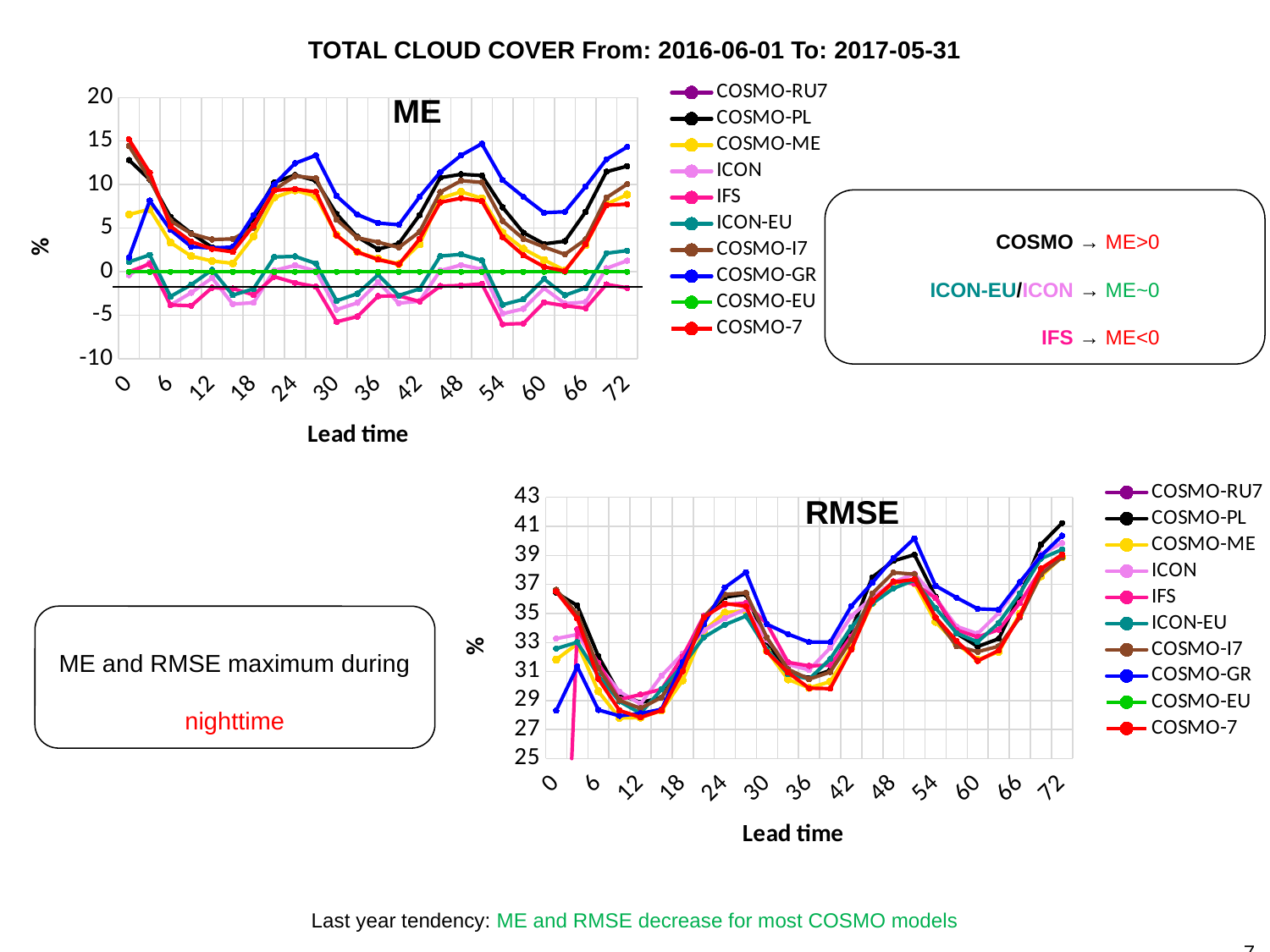
How many series does the legend of the RMSE chart list? 10 In the RMSE chart, which series has the lowest value at lead time 0? COSMO-GR In the RMSE chart, is the value for COSMO-GR at lead time 6 greater or less than 29? less In the RMSE chart, is the value for COSMO-GR at lead time 54 greater or less than 39? less What is the title printed above both charts? TOTAL CLOUD COVER From: 2016-06-01 To: 2017-05-31 What type of chart is the ME chart? line chart In the ME chart, which is larger at lead time 54: COSMO-GR or IFS? COSMO-GR How many lead-time tick labels are shown on the x axis of the RMSE chart? 13 In the ME chart, is the value for IFS at lead time 30 greater or less than 0? less What is the x-axis label of the ME chart? Lead time